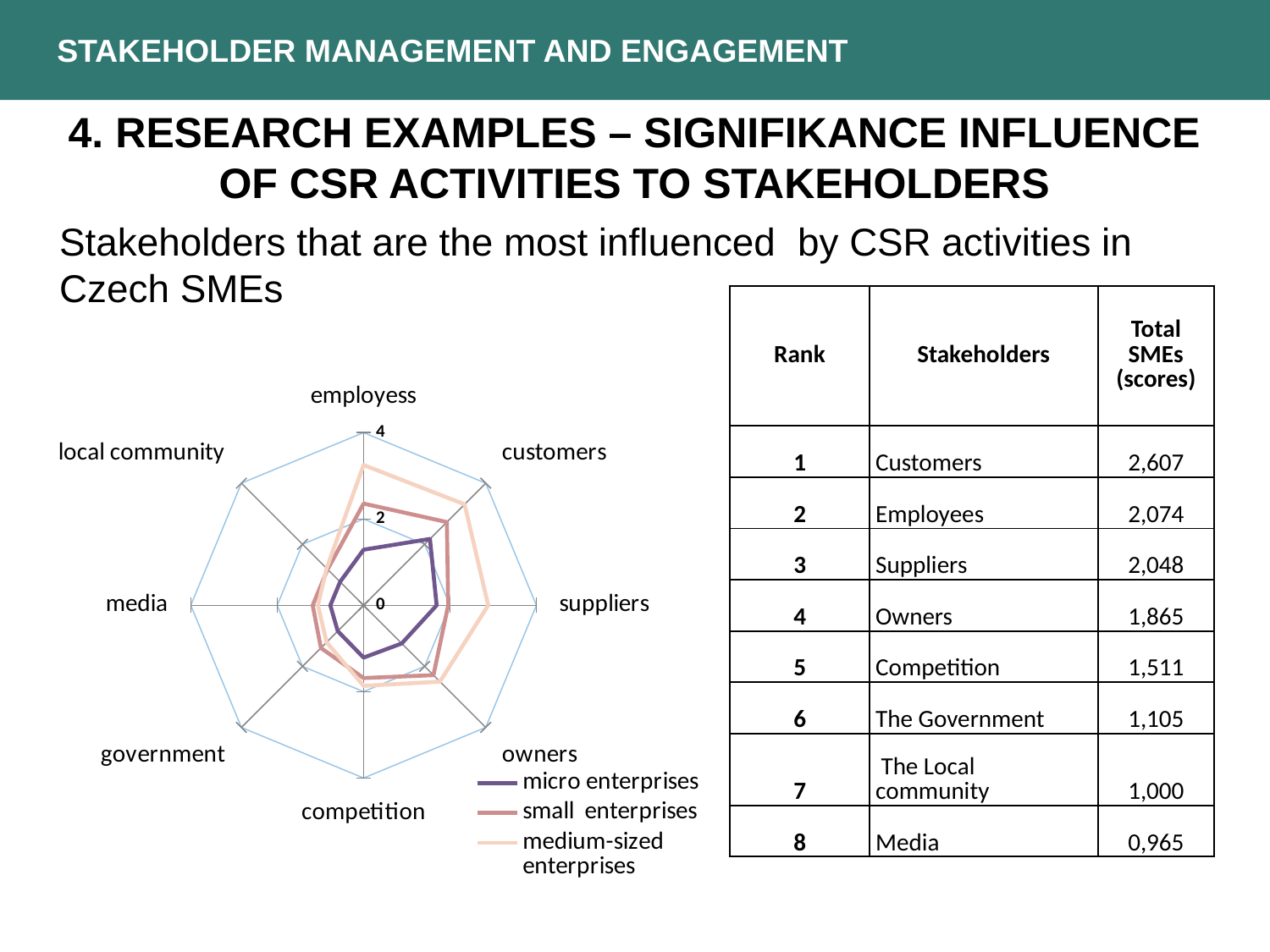
What kind of chart is shown on the slide? radar chart What is the highest value shown on the radar chart's axis scale? 4 For customers, which series has the larger value: medium-sized enterprises or micro enterprises? medium-sized enterprises Is the value for customers for small enterprises greater or less than 2? greater How many stakeholder categories are plotted on the radar chart? 8 Is the value for media for micro enterprises greater or less than 2? less For employess, which series has the larger value: micro enterprises or medium-sized enterprises? medium-sized enterprises Is the value for employess for micro enterprises greater or less than 2? less Which series is drawn in purple on the radar chart? micro enterprises How many series does the legend of the radar chart list? 3